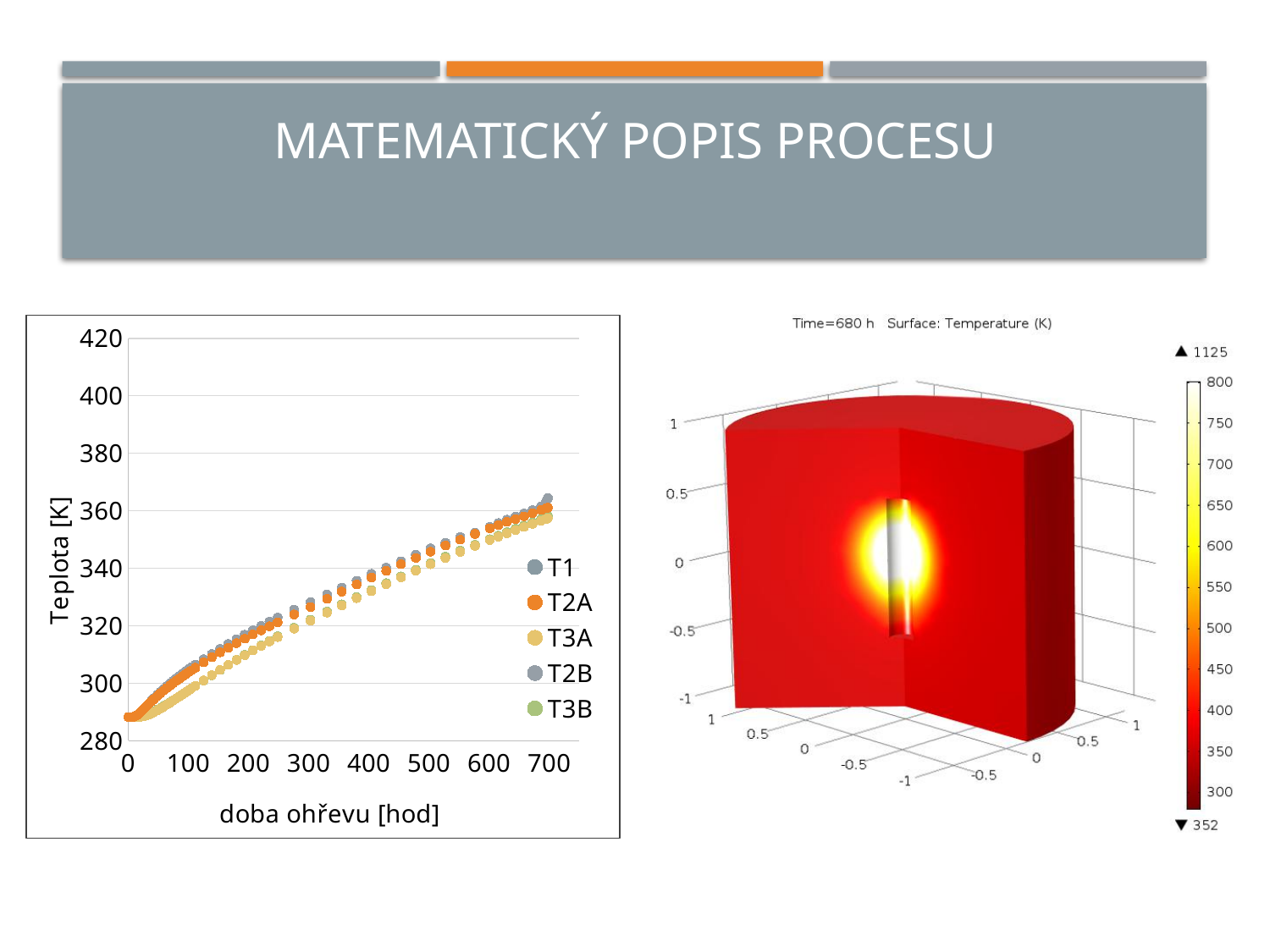
In the chart on the left, how many series does the legend list? 5 What kind of chart is shown on the left of the slide? scatter chart In the chart on the left, do the temperature values rise or fall as the heating time (doba ohřevu) increases? rise In the chart on the left, is the value for T1 at 700 hours greater or less than 340? greater In the chart on the left, which series are listed in the legend? T1, T2A, T3A, T2B, T3B In the chart on the left, is the starting value of the series at 0 hours greater or less than 300? less In the chart on the left, what is the highest tick value shown on the vertical axis? 420 In the chart on the left, is the value for T3A at 300 hours greater or less than 340? less In the chart on the left, at 700 hours, which series has the higher value, T1 or T3A? T1